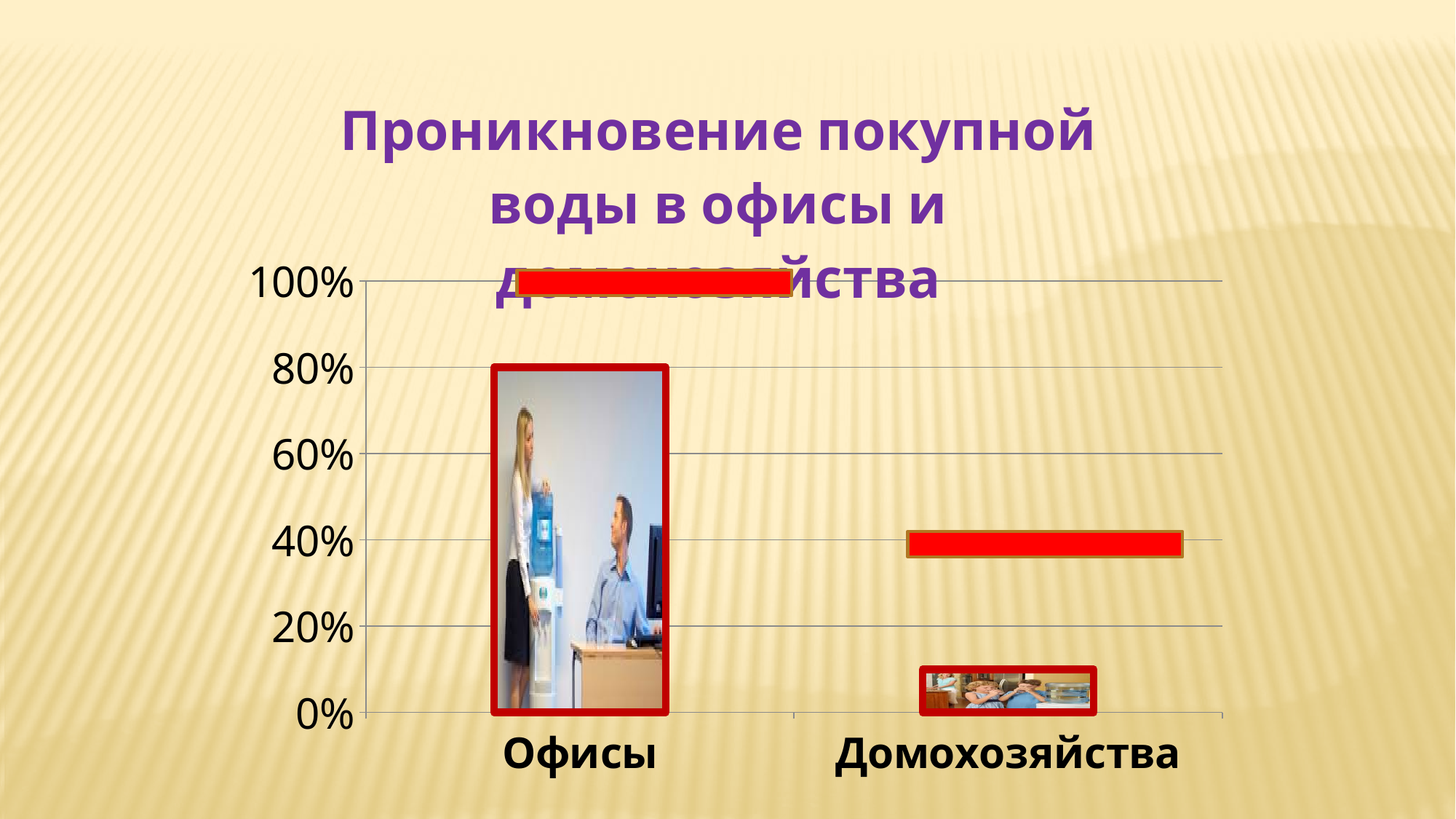
What is the title of the chart on the slide? Проникновение покупной воды в офисы и домохозяйства How many categories are shown on the x axis of the chart? 2 What kind of chart is shown on the slide? bar chart Is the value for Офисы greater or less than 60%? greater Which bar is taller, Офисы or Домохозяйства? Офисы What is the highest tick label on the y axis of the chart? 100% Is the value for Офисы greater or less than 100%? less Which category has the lowest bar in the chart? Домохозяйства Which category has the highest bar in the chart? Офисы Is the value for Домохозяйства greater or less than 20%? less What value does the top of the Офисы bar reach on the y axis? 80%